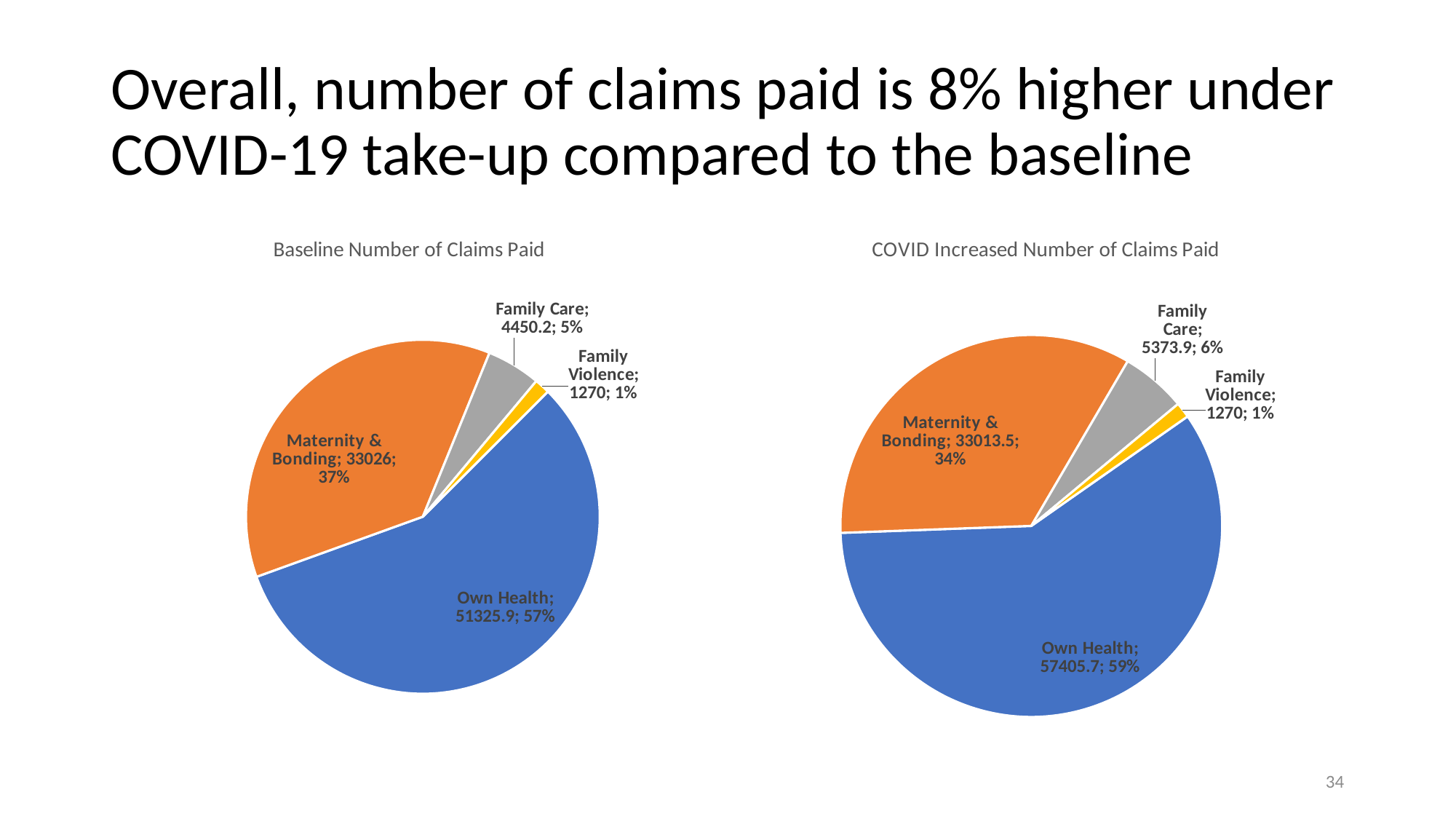
In the 'Baseline Number of Claims Paid' chart, which is larger, Family Care or Family Violence? Family Care In the 'Baseline Number of Claims Paid' chart, what is the value for Own Health? 51325.9 In the 'Baseline Number of Claims Paid' chart, which category has the largest slice? Own Health What kind of chart is the 'COVID Increased Number of Claims Paid' chart? Pie chart In the 'COVID Increased Number of Claims Paid' chart, what colour is the Maternity & Bonding slice? Orange In the 'COVID Increased Number of Claims Paid' chart, which category has the smallest slice? Family Violence In the 'COVID Increased Number of Claims Paid' chart, what is the value for Family Care? 5373.9 How many categories does the 'Baseline Number of Claims Paid' chart show? 4 What is the title of the chart on the left of the slide? Baseline Number of Claims Paid In the 'COVID Increased Number of Claims Paid' chart, what is the difference between the Own Health value and the Maternity & Bonding value? 24392.2 In the 'COVID Increased Number of Claims Paid' chart, what share of the pie is Own Health? 59% In the 'Baseline Number of Claims Paid' chart, what share of the pie is Maternity & Bonding? 37%